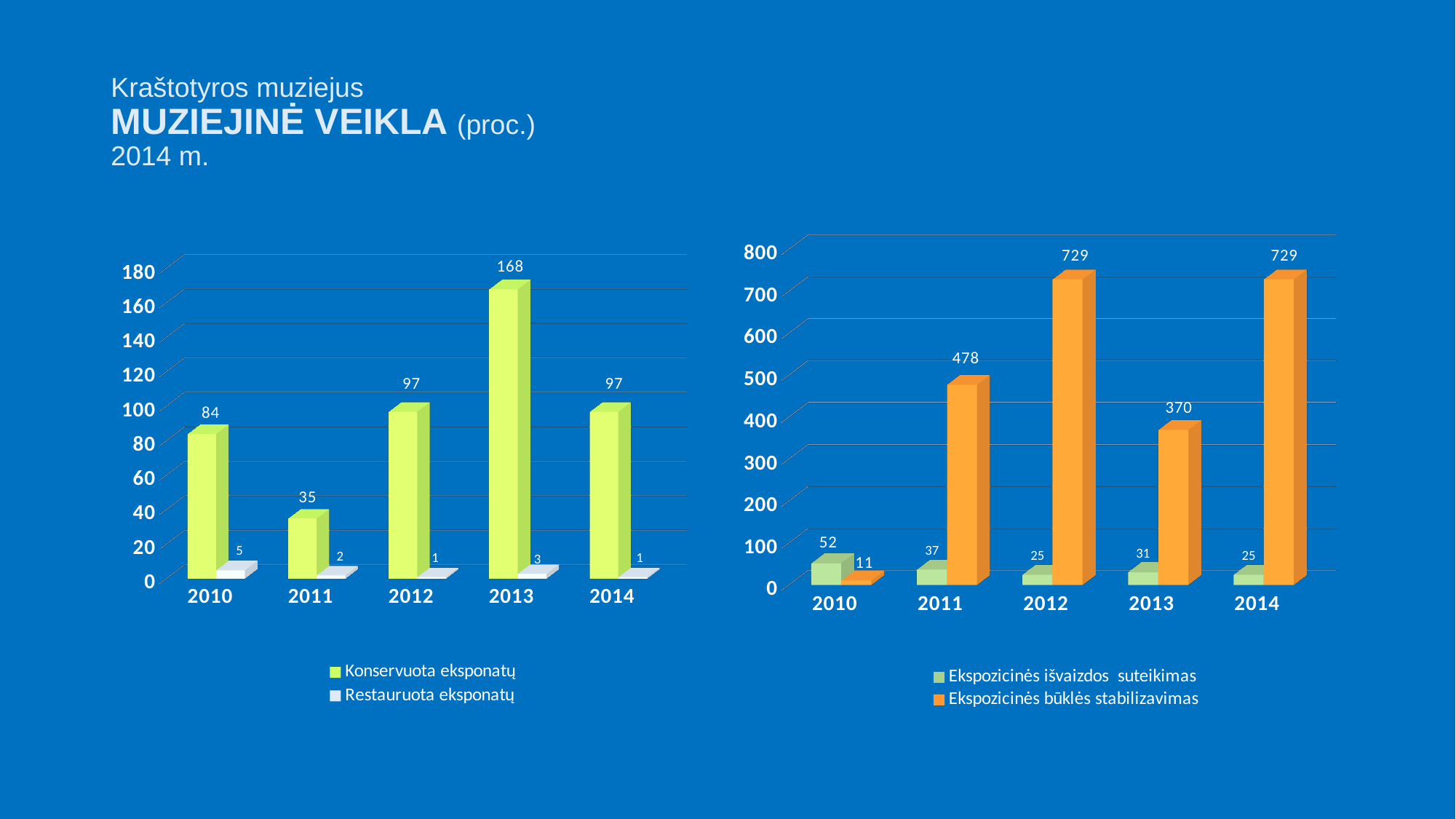
What type of chart is the left chart? bar chart In the right chart, what is the difference between the Ekspozicinės būklės stabilizavimas values for 2012 and 2013? 359 In the right chart, which year has the lowest value for Ekspozicinės būklės stabilizavimas? 2010 In the left chart, how many series does the legend list? 2 In the left chart, which year has the lowest value for Konservuota eksponatų? 2011 In the left chart, what is the value of Restauruota eksponatų for 2010? 5 In the right chart, what is the value of Ekspozicinės būklės stabilizavimas for 2011? 478 How many years are shown on the x axis of the right chart? 5 In the left chart, what is the difference between the Konservuota eksponatų values for 2013 and 2012? 71 In the right chart, is the value of Ekspozicinės būklės stabilizavimas for 2013 larger or smaller than for 2011? smaller In the right chart, what is the value of Ekspozicinės išvaizdos suteikimas for 2010? 52 In the left chart, what is the value of Konservuota eksponatų for 2013? 168